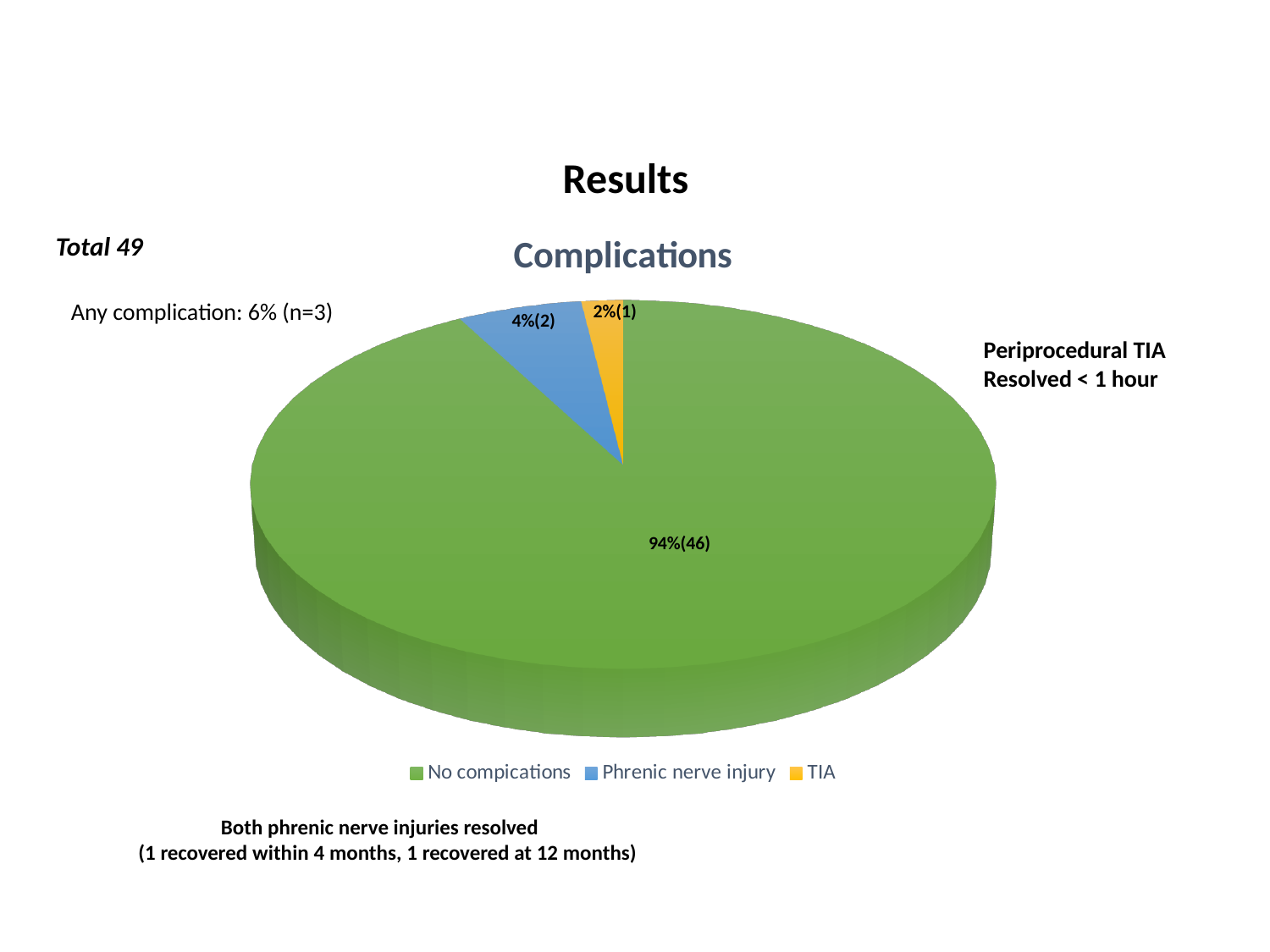
What is the title of the chart? Complications Which category has the largest slice of the pie? No compications What kind of chart is shown on the slide? pie chart How many entries does the legend list? 3 Which category has the smallest slice of the pie? TIA What is the data label for the Phrenic nerve injury slice? 4%(2) What colour is the TIA slice? yellow What share of the pie does the Phrenic nerve injury slice represent? 4% Which slice is larger, Phrenic nerve injury or TIA? Phrenic nerve injury What is the data label for the No compications slice? 94%(46) What is the data label for the TIA slice? 2%(1) How many slices does the pie chart have? 3